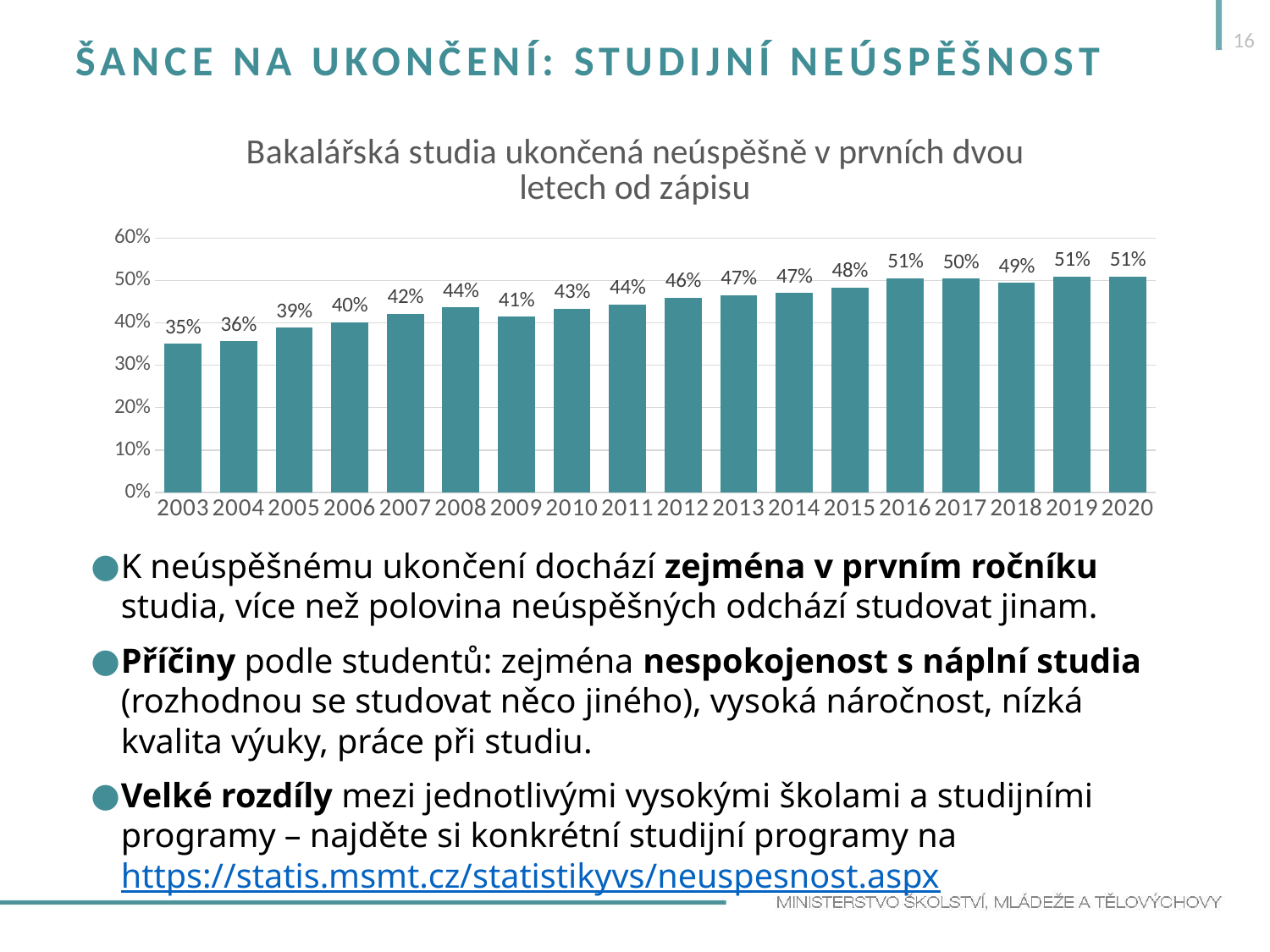
Do the values generally rise or fall from 2003 to 2020? rise What is the value for 2020? 51% What kind of chart is shown on the slide? bar chart Which is larger, the value for 2017 or the value for 2018? 2017 What is the value for 2003? 35% Is the value for 2005 greater or less than 40%? less What is the difference between the values for 2008 and 2009? 3% Which year has the lowest value? 2003 How many years are shown on the x axis? 18 What is the difference between the values for 2020 and 2003? 16% What is the value for 2009? 41% What is the value for 2012? 46%